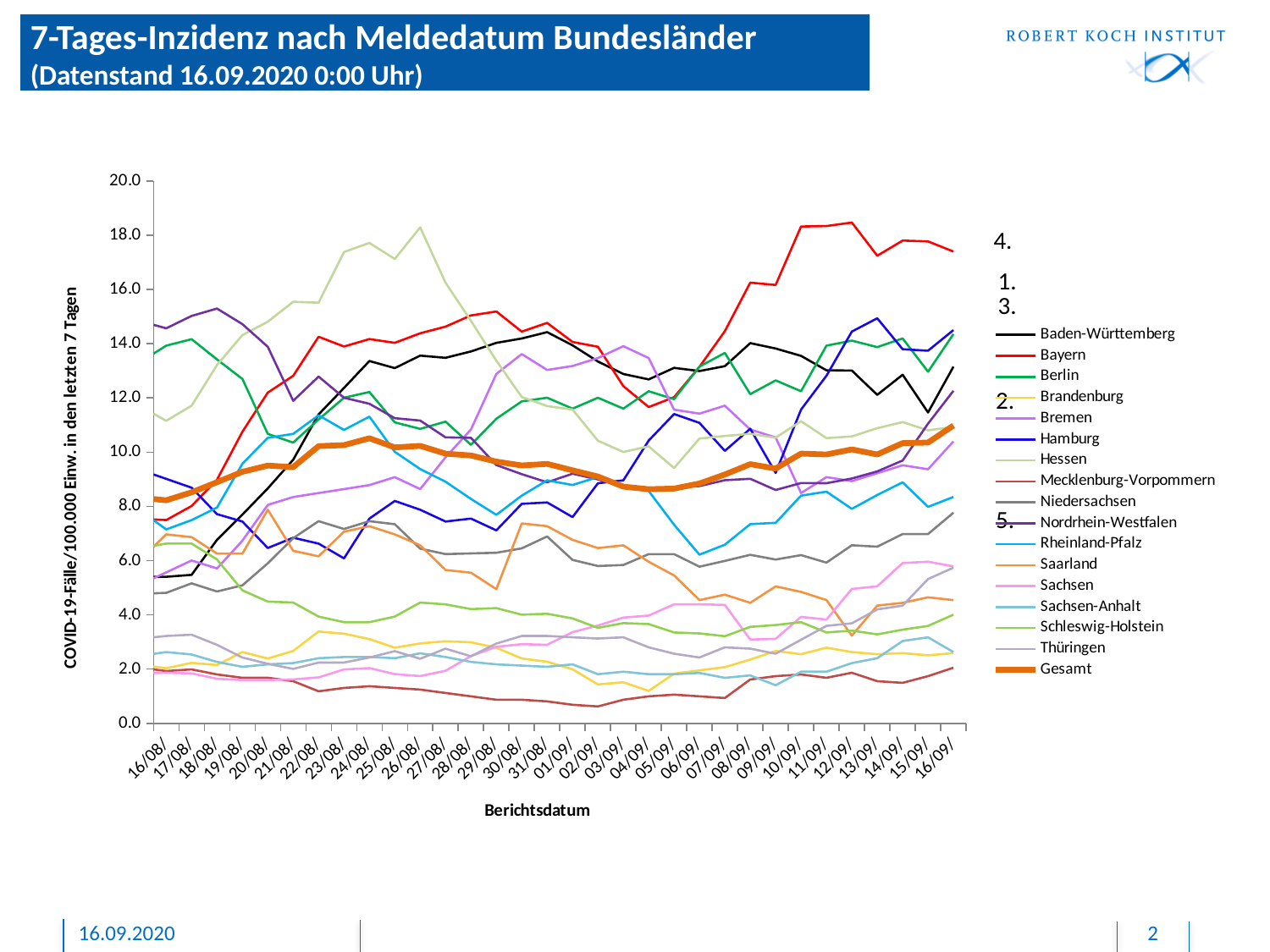
How many dates are shown along the x axis? 32 On 16/08, which is larger: the value for Hessen or the value for Bayern? Hessen Is the value for Bayern on 16/09 greater or less than 16.0? greater Is the value for Hessen on 26/08 greater or less than 16.0? greater What kind of chart is shown on the slide? line chart Is the value for Gesamt on 16/09 greater or less than 10.0? greater What is the title of the x axis? Berichtsdatum Does the Bayern line rise or fall overall from 16/08 to 16/09? rise Which series has the highest value on 16/09? Bayern How many series does the legend list? 17